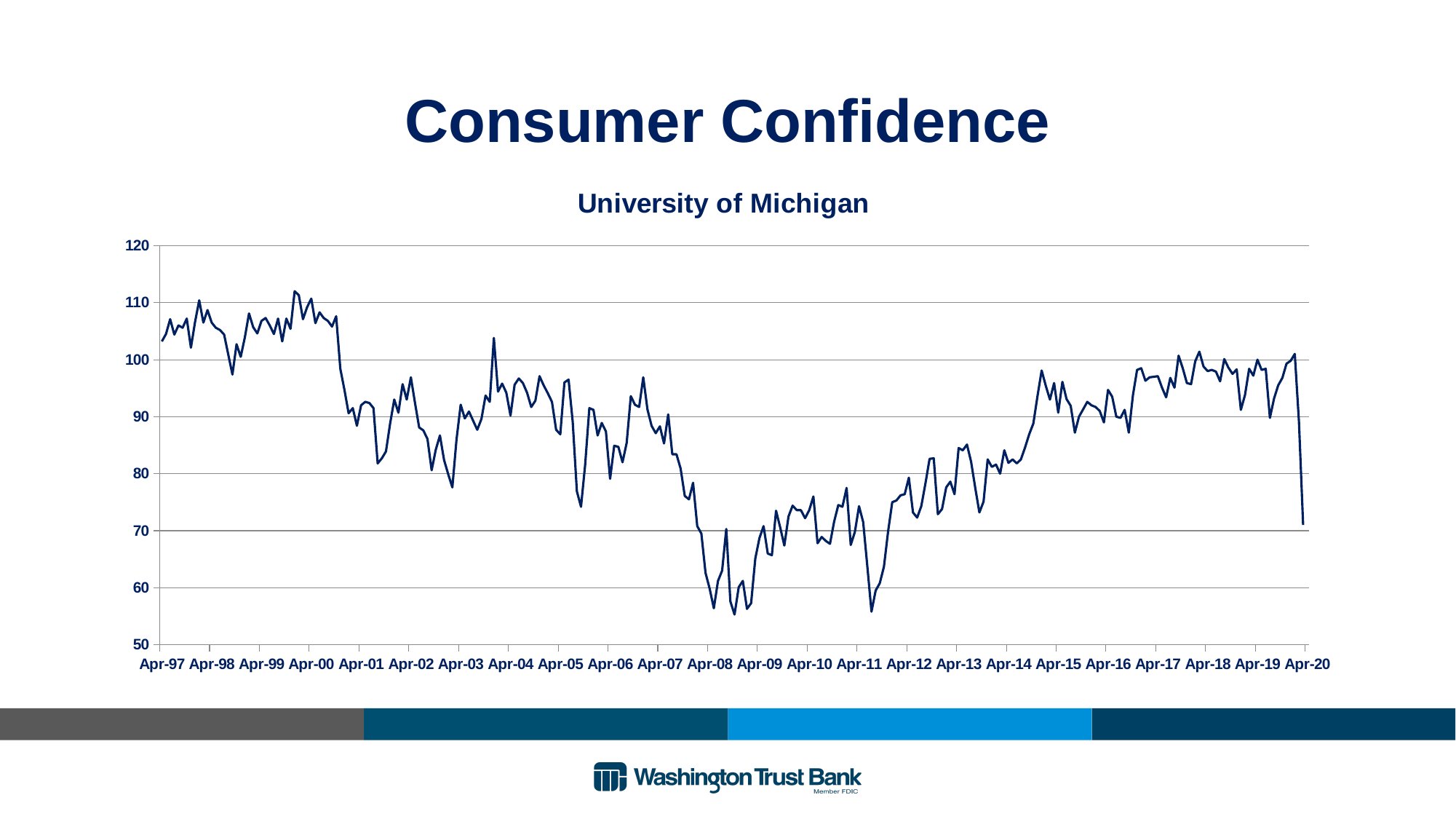
Is the value at Apr-13 greater or less than 80? greater How many x-axis labels are shown on the chart? 24 What is the title shown directly above the chart? University of Michigan What kind of chart is shown on the slide? line chart Near which x-axis label does the line reach its highest value? Apr-00 Does the line overall rise or fall from Apr-11 to Apr-18? rise Is the value at Apr-00 greater or less than 100? greater Is the value at Apr-97 greater or less than 100? greater What is the highest value shown on the y axis? 120